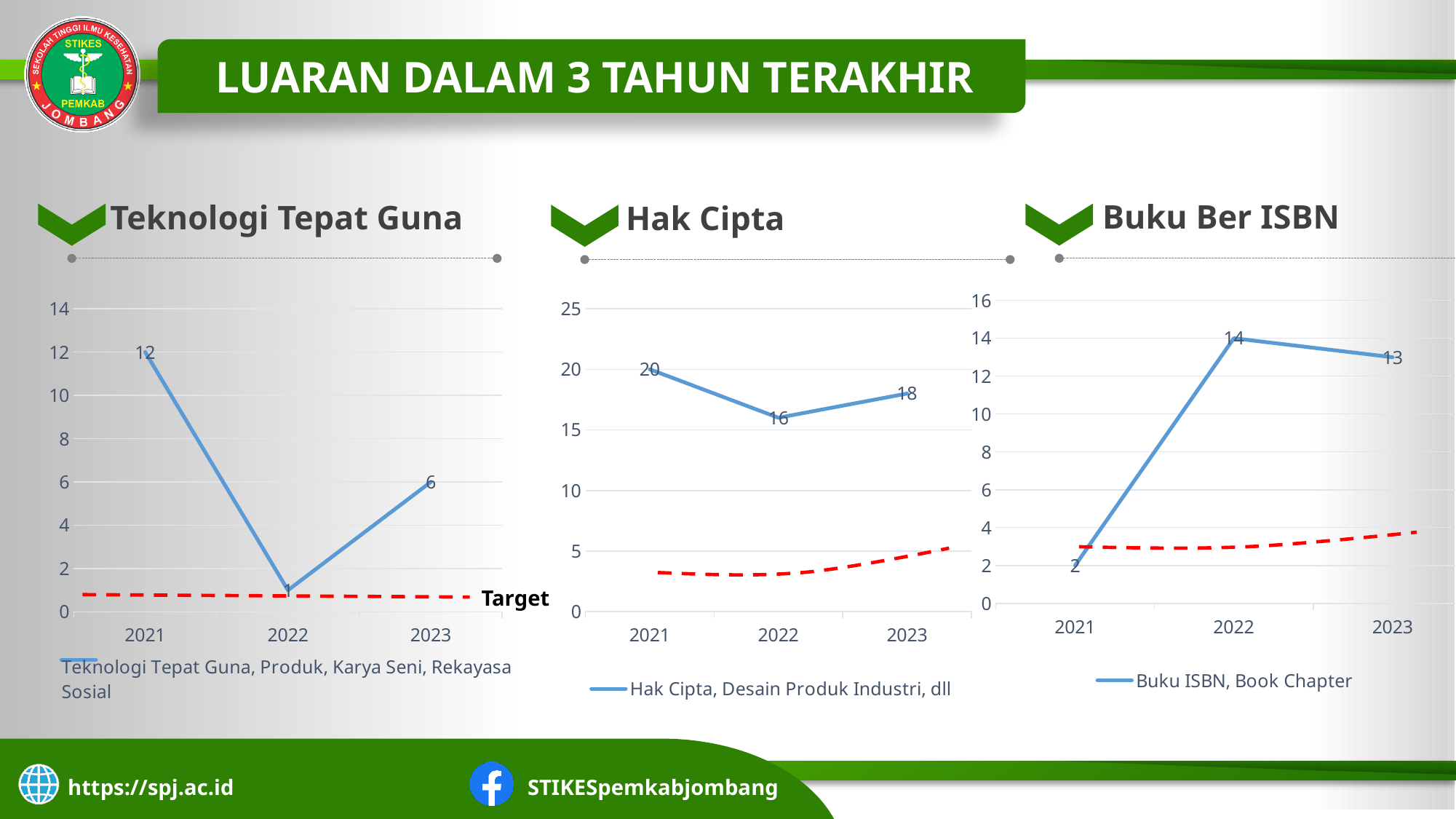
In the Buku Ber ISBN chart, which is larger, the value for 2021 or the value for 2023? 2023 In the Buku Ber ISBN chart, what is the value for 2022? 14 How many years are plotted on the x axis of the Buku Ber ISBN chart? 3 In the Hak Cipta chart, what is the difference between the 2021 and 2023 values? 2 What kind of chart is the Hak Cipta chart? Line chart In the Hak Cipta chart, which year has the lowest value? 2022 In the Teknologi Tepat Guna chart, what is the value for 2022? 1 In the Teknologi Tepat Guna chart, what is the difference between the 2021 and 2023 values? 6 In the Teknologi Tepat Guna chart, what is the value for 2021? 12 In the Hak Cipta chart, what is the value for 2022? 16 In the Teknologi Tepat Guna chart, which year has the highest value? 2021 In the Buku Ber ISBN chart, what is the difference between the 2022 and 2021 values? 12